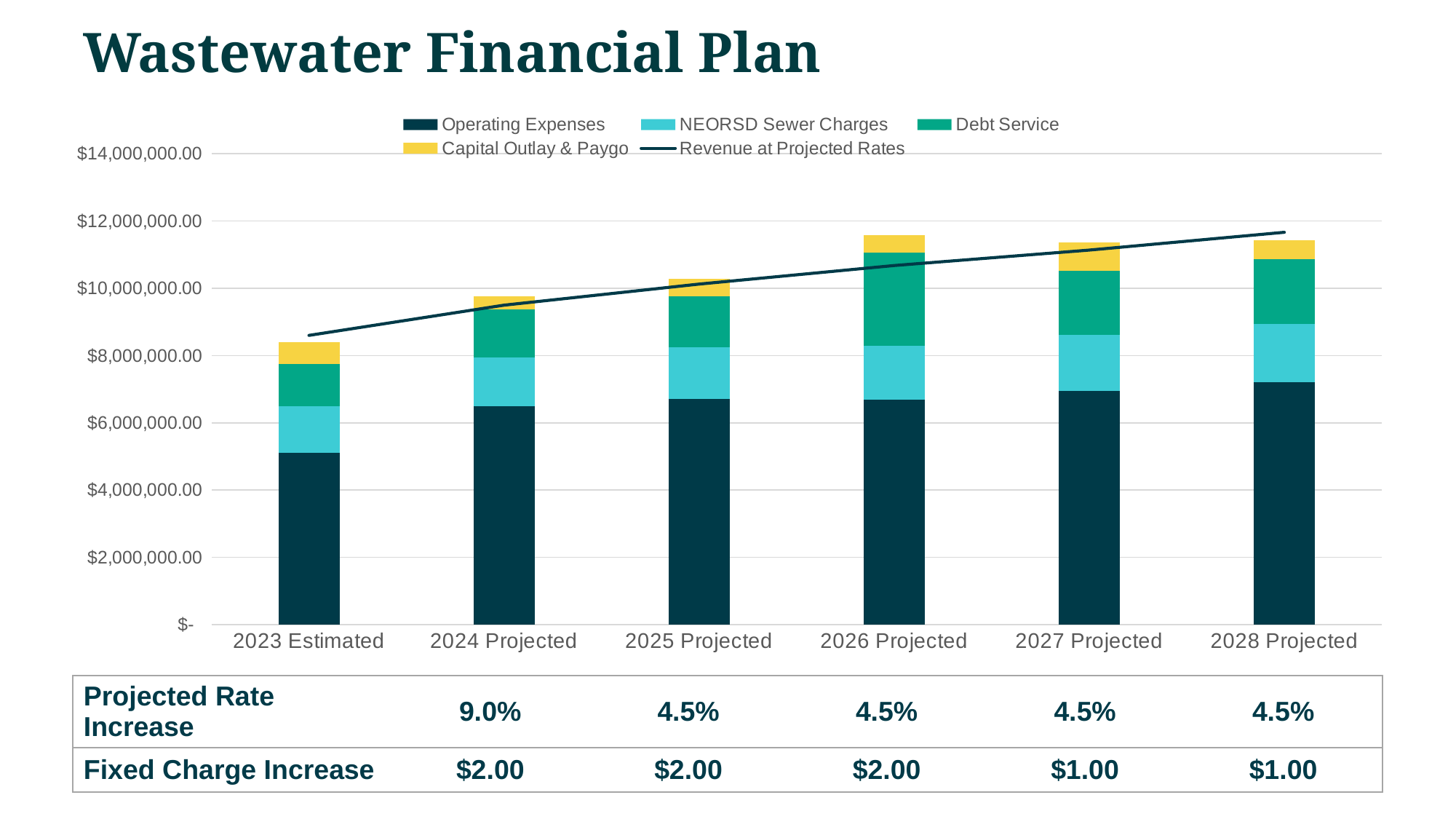
Is the Operating Expenses value for 2023 Estimated greater or less than $6,000,000.00? less Is the total stacked bar for 2026 Projected greater or less than $12,000,000.00? less Is the Revenue at Projected Rates value for 2028 Projected greater or less than $10,000,000.00? greater How many series does the chart legend list? 5 How many categories are shown along the x axis of the chart? 6 Which category has the tallest Operating Expenses segment? 2028 Projected Which series is shown in yellow in the chart legend? Capital Outlay & Paygo Does the Revenue at Projected Rates line rise or fall from 2023 Estimated to 2028 Projected? rise Which is larger, the total stacked bar for 2024 Projected or for 2026 Projected? 2026 Projected Which category has the lowest total stacked bar? 2023 Estimated What kind of chart is shown on the slide? stacked bar chart with a line